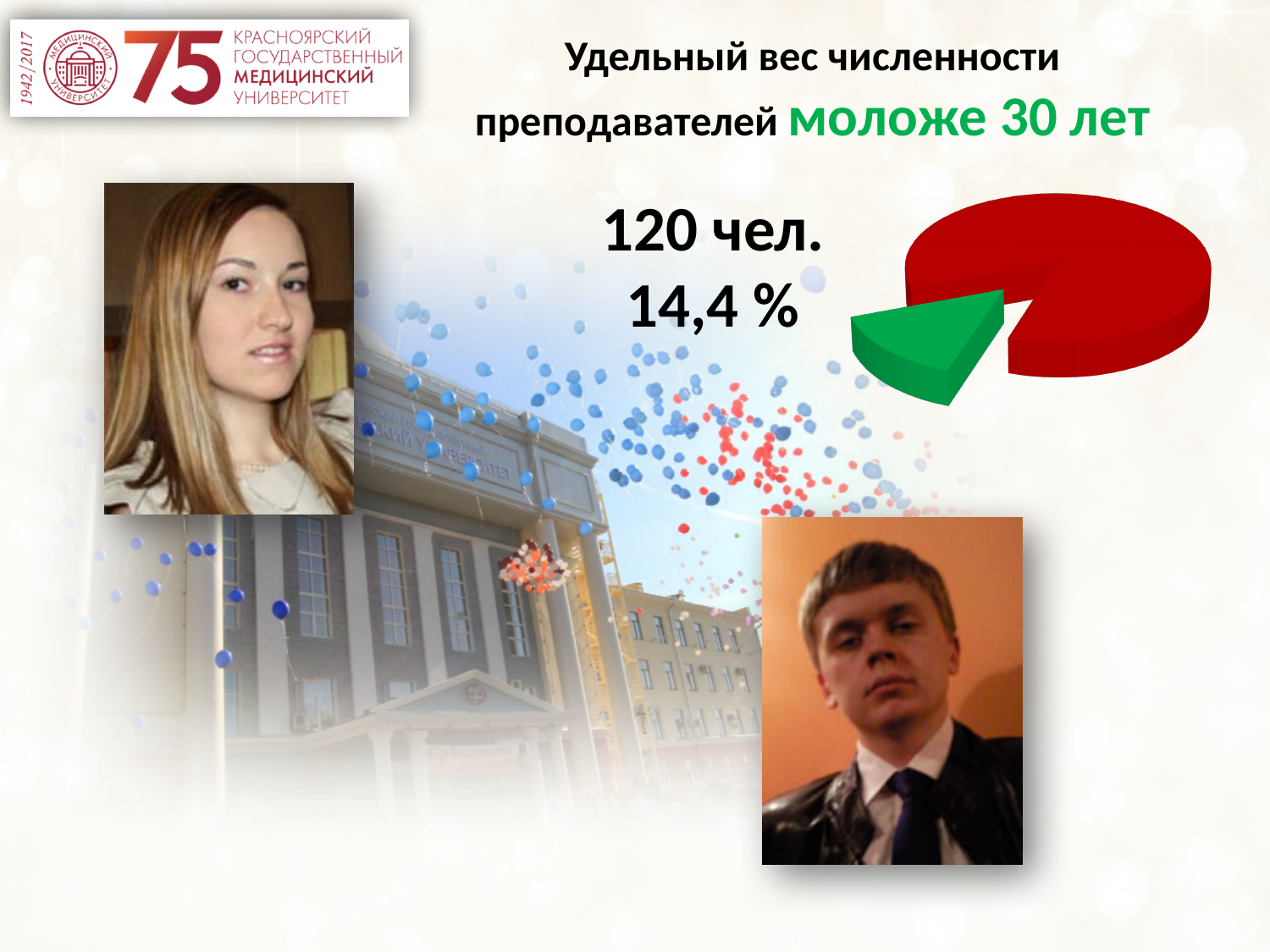
What is the title of the slide with the pie chart? Удельный вес численности преподавателей моложе 30 лет What share of the pie does the green slice (teachers younger than 30) represent? 14,4 % What colour is the exploded (pulled-out) slice of the pie chart? green Which slice of the pie chart is the smallest? the green slice (teachers younger than 30) How many slices does the pie chart have? 2 Which slice of the pie chart is the largest? the red slice How many teachers younger than 30 are there according to the slide? 120 чел. What kind of chart is shown on the slide? pie chart Which slice of the pie chart is larger, the red one or the green one? the red one